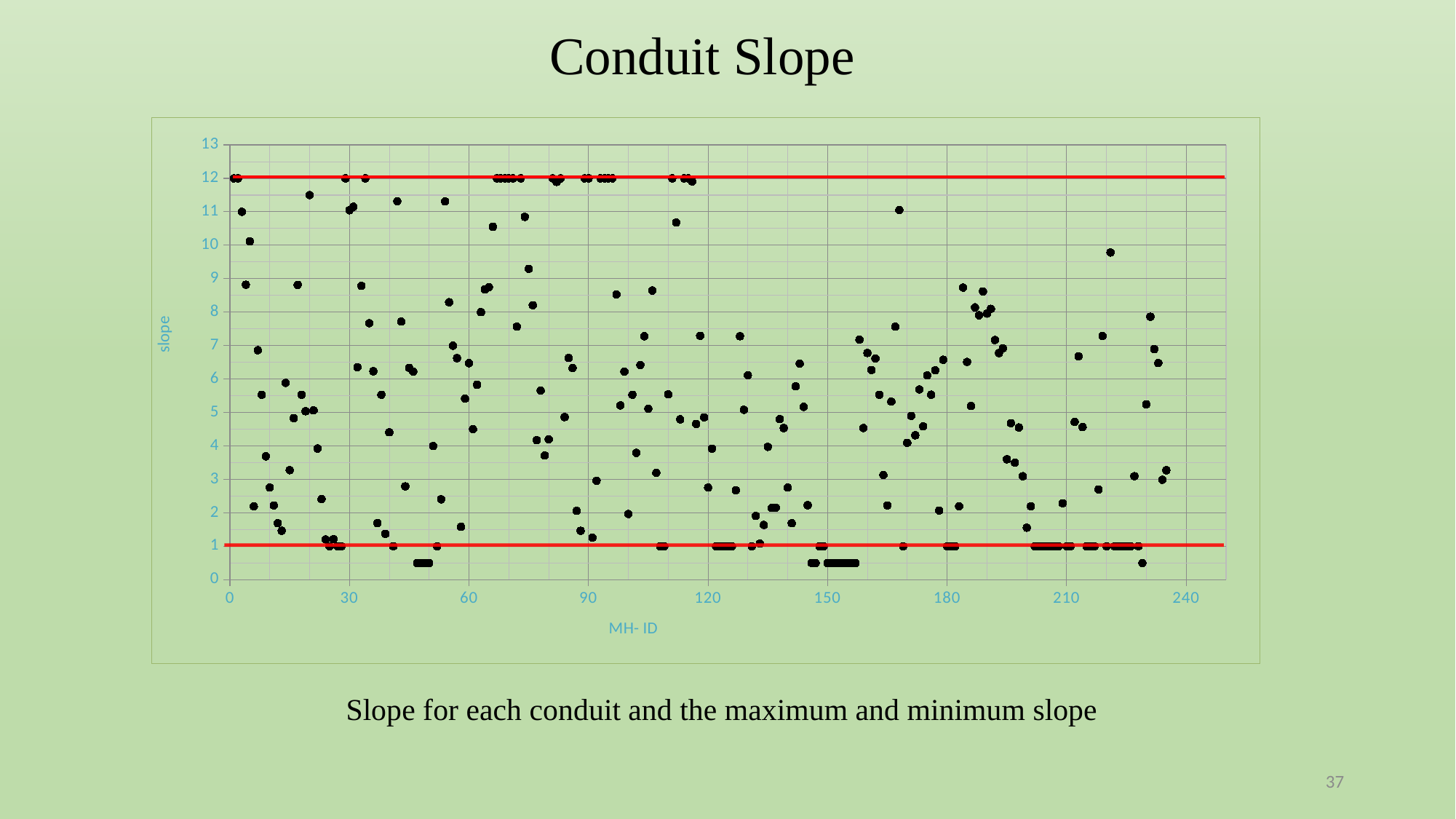
Is the highest plotted slope value greater or less than 11? greater Is the lowest plotted slope value greater or less than 1? less What is the interval between consecutive tick labels on the x axis? 30 What is the highest tick value shown on the x axis? 240 What is the title of the y axis of the chart? slope Is the slope of the point plotted near MH-ID 220 at the top of the chart greater or less than 9? greater What kind of chart is shown on the slide? scatter chart What is the title of the x axis of the chart? MH- ID What is the highest tick value shown on the y axis? 13 At what slope value is the lower red horizontal line drawn? 1 At what slope value is the upper red horizontal line drawn? 12